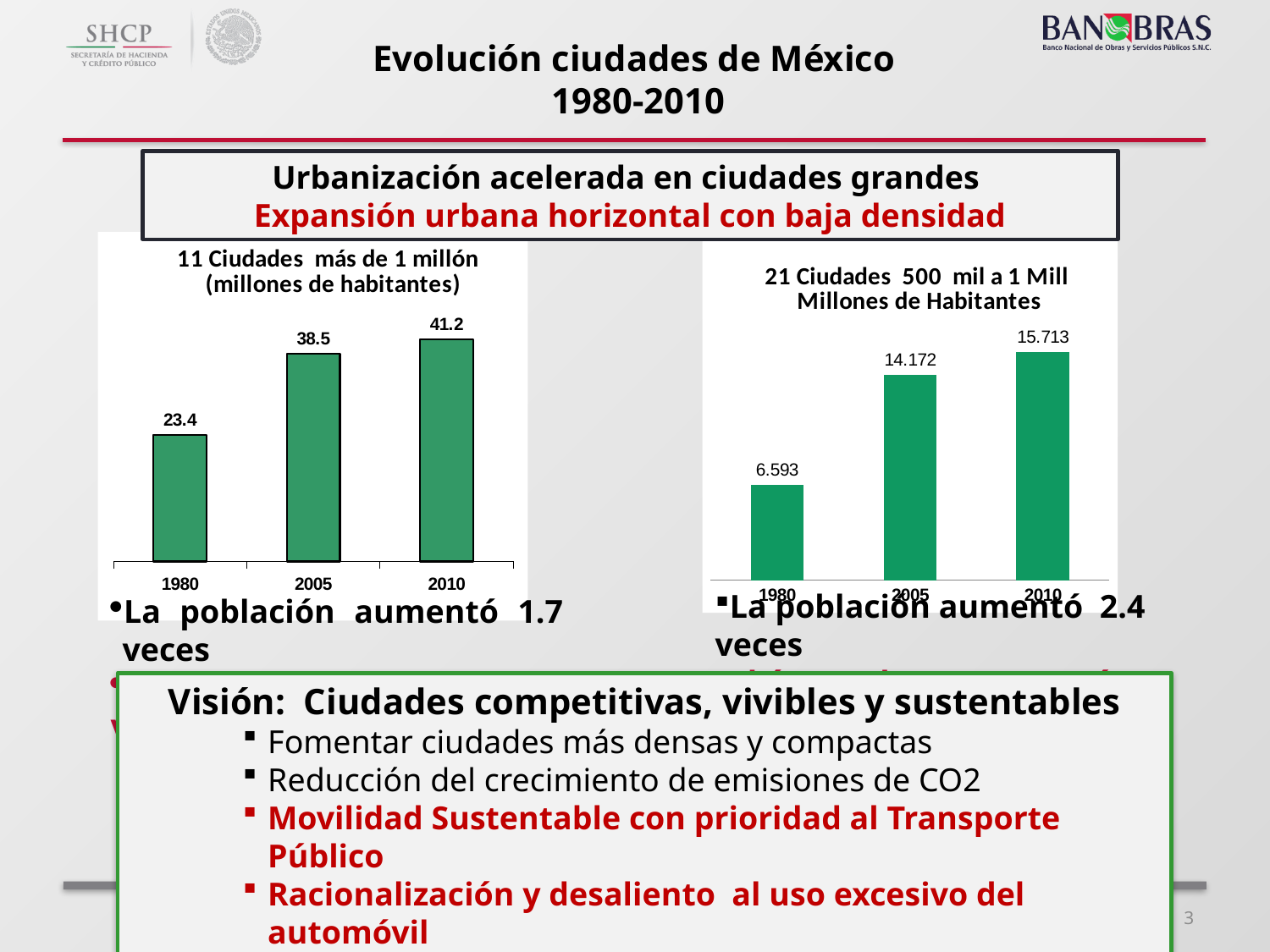
In the left chart (11 Ciudades más de 1 millón), what is the difference between the 2010 and 1980 values? 17.8 In the left chart (11 Ciudades más de 1 millón), what is the value for 1980? 23.4 In the right chart (21 Ciudades 500 mil a 1 Mill), which year has the lowest value? 1980 In the right chart (21 Ciudades 500 mil a 1 Mill), what is the value for 1980? 6.593 What type of chart is the left chart (11 Ciudades más de 1 millón)? Bar chart In the left chart (11 Ciudades más de 1 millón), how many bars are plotted? 3 In the left chart (11 Ciudades más de 1 millón), what is the value for 2005? 38.5 In the right chart (21 Ciudades 500 mil a 1 Mill), which is larger, the value for 2005 or the value for 2010? 2010 In the right chart (21 Ciudades 500 mil a 1 Mill), what is the value for 2010? 15.713 In the right chart (21 Ciudades 500 mil a 1 Mill), what is the difference between the 2005 and 1980 values? 7.579 In the left chart (11 Ciudades más de 1 millón), which year has the highest value? 2010 In the right chart (21 Ciudades 500 mil a 1 Mill), do the values rise or fall from 1980 to 2010? Rise